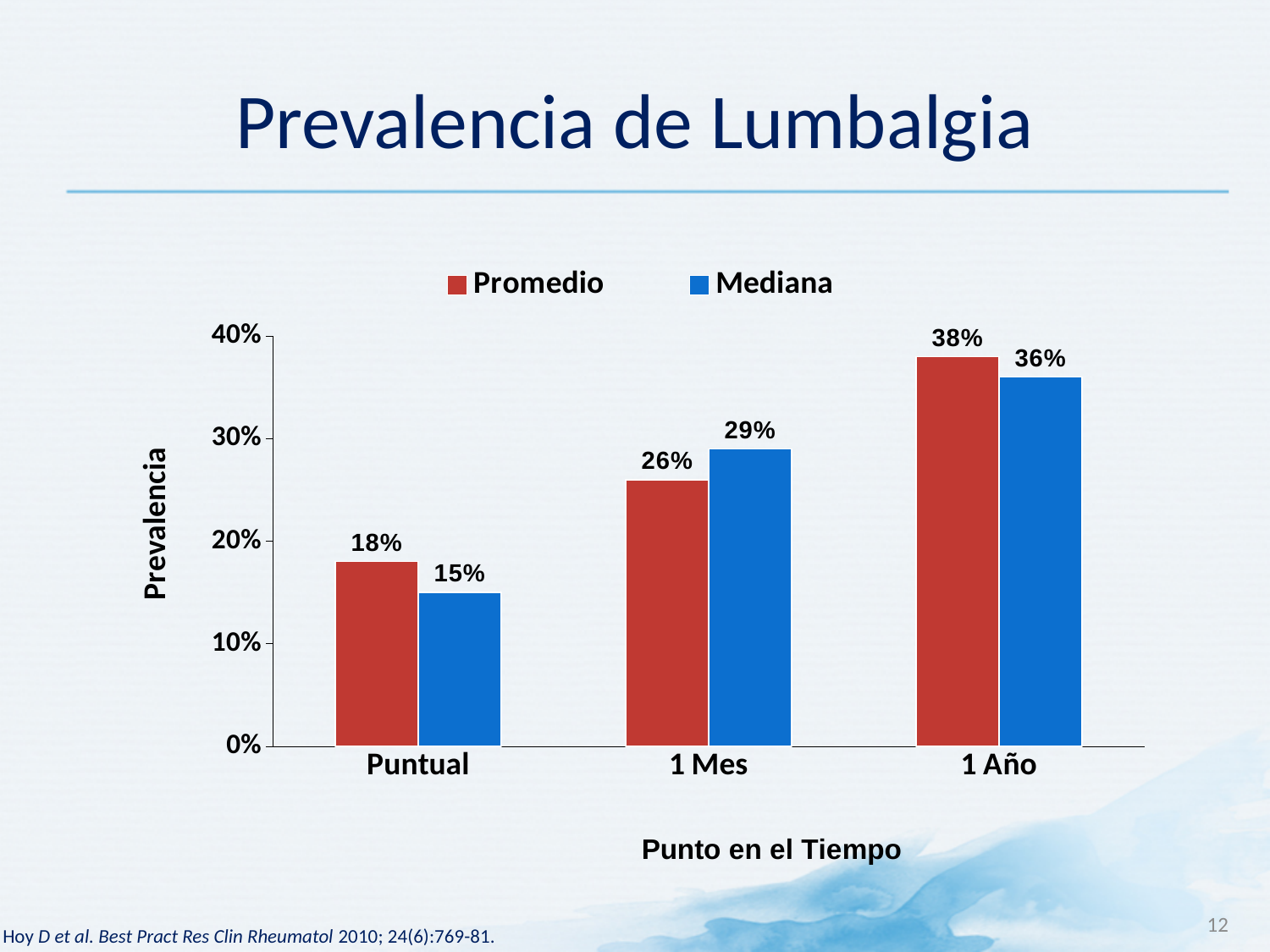
How many categories are shown on the x axis? 3 What is the Mediana value for 1 Mes? 29% Do the Promedio values rise or fall from Puntual to 1 Año? Rise Which category has the highest Mediana value? 1 Año Which category has the lowest Promedio value? Puntual What is the Promedio value for 1 Año? 38% What kind of chart is shown? Bar chart Is the Mediana value for 1 Año greater or less than 30%? greater Which is larger for 1 Mes, Promedio or Mediana? Mediana What is the difference between the Promedio and Mediana values for Puntual? 3% How many series does the legend list? 2 What is the Promedio value for Puntual? 18%